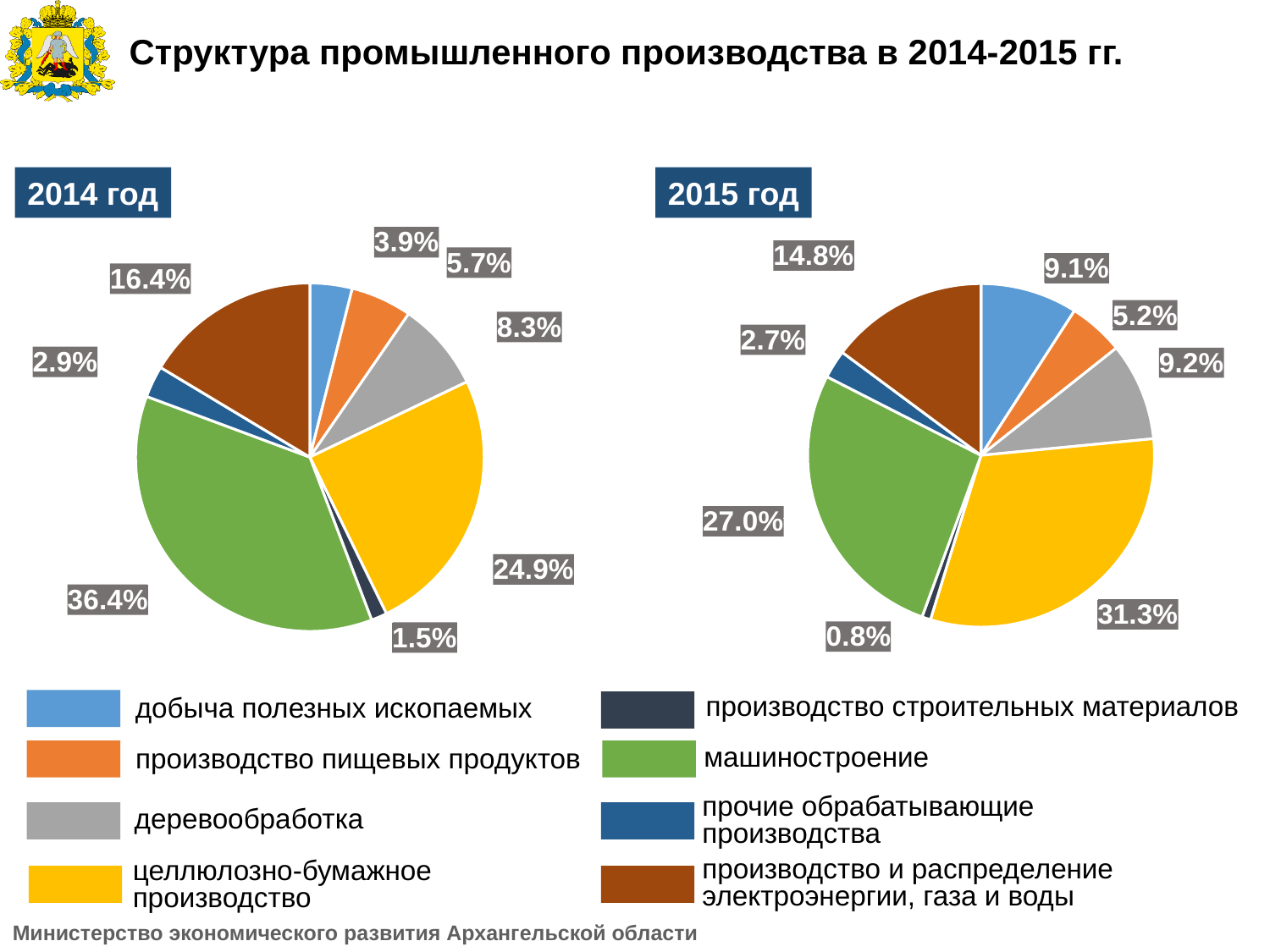
What type of chart is used for the 2014 год and 2015 год data? pie chart In the 2015 год pie chart, which is larger: деревообработка or производство пищевых продуктов? деревообработка In the 2015 год pie chart, what is the share of добыча полезных ископаемых? 9.1% What is the difference between the share of машиностроение in the 2014 год chart and in the 2015 год chart? 9.4% In the 2014 год pie chart, what is the share of производство и распределение электроэнергии, газа и воды? 16.4% In the 2014 год pie chart, which category has the smallest share? производство строительных материалов In the 2015 год pie chart, which category has the smallest share? производство строительных материалов How many categories does the legend list for the pie charts? 8 In the 2014 год pie chart, which category has the largest share? машиностроение In the 2015 год pie chart, what share does целлюлозно-бумажное производство have? 31.3% In the 2015 год pie chart, which category has the largest share? целлюлозно-бумажное производство In the 2014 год pie chart, what share does машиностроение have? 36.4%